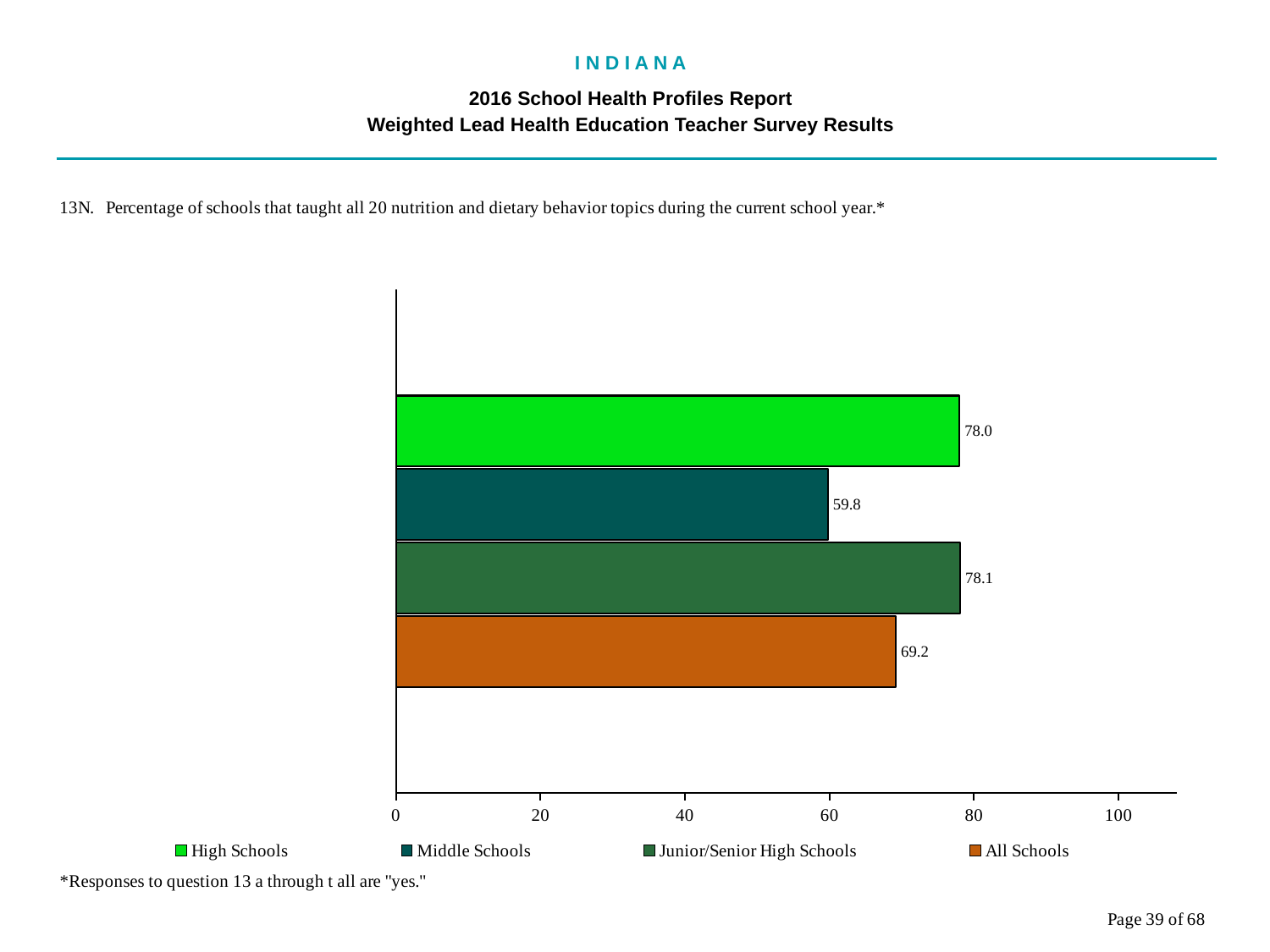
Which category has the lowest value? Middle Schools What colour is the bar for All Schools? orange What is the value for Middle Schools? 59.8 What is the difference between the values for All Schools and Middle Schools? 9.4 What is the value for High Schools? 78.0 What is the difference between the values for High Schools and Middle Schools? 18.2 What kind of chart is shown on the slide? bar chart Is the value for Middle Schools greater or less than 80? less What is the value for Junior/Senior High Schools? 78.1 What is the value for All Schools? 69.2 How many series does the legend list? 4 Which is larger, the value for All Schools or the value for Middle Schools? All Schools